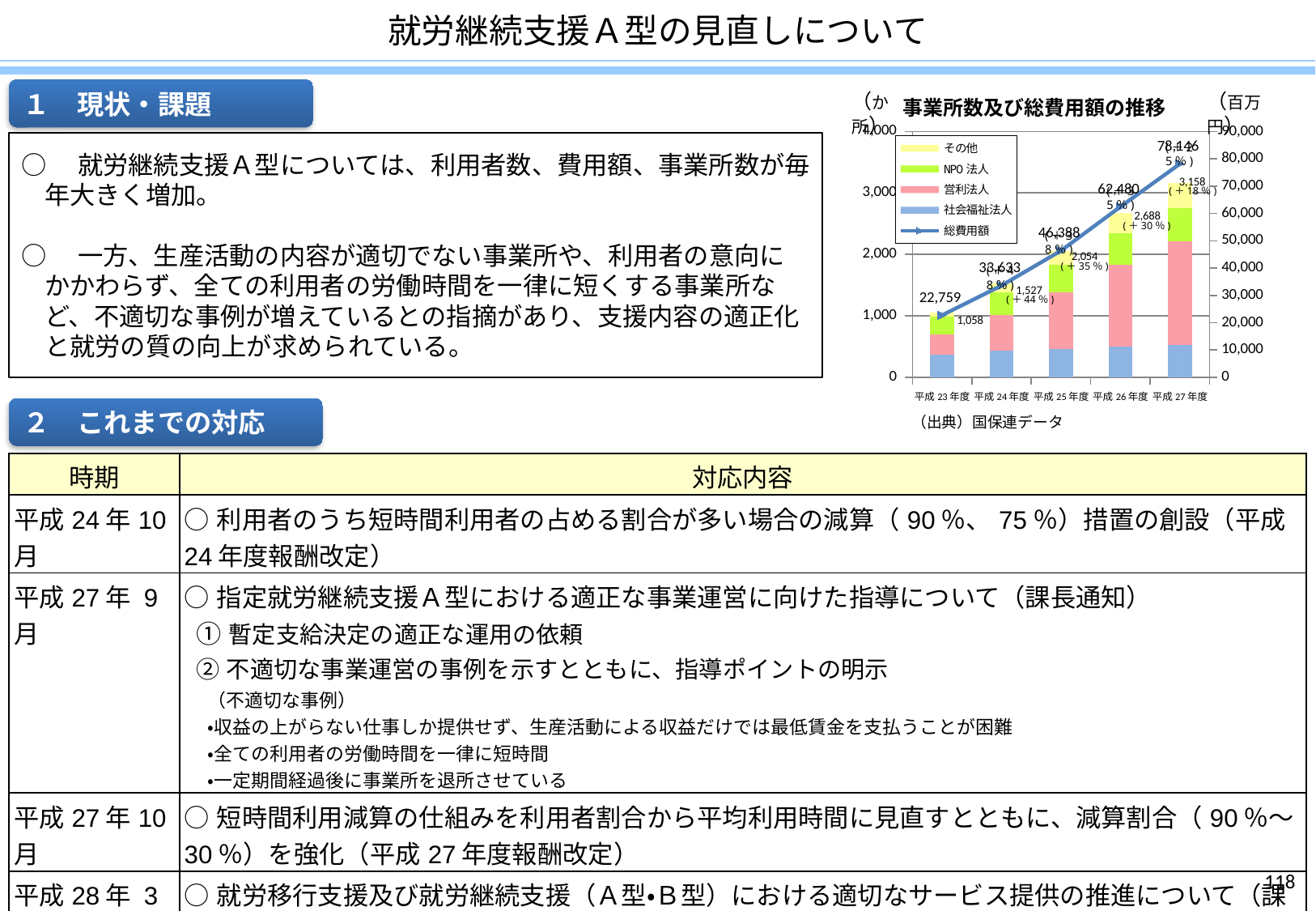
By how much did the total number of 事業所 increase from 平成23年度 (1,058) to 平成27年度 (3,158)? 2,100 What is the total number of 事業所 for 平成27年度? 3,158 Does the 総費用額 line rise or fall from 平成23年度 to 平成27年度? Rise What is the 総費用額 value for 平成23年度? 22,759 Which fiscal year has the lowest total number of 事業所? 平成23年度 What is the total number of 事業所 for 平成24年度? 1,527 Which fiscal year has the highest 総費用額? 平成27年度 What is the 総費用額 value for 平成27年度? 78,146 In 平成27年度, which segment is larger: 営利法人 or 社会福祉法人? 営利法人 How many entries does the chart's legend list? 5 How many fiscal years are shown on the x axis of the chart? 5 What kind of chart is shown on the slide? Stacked bar chart with a line